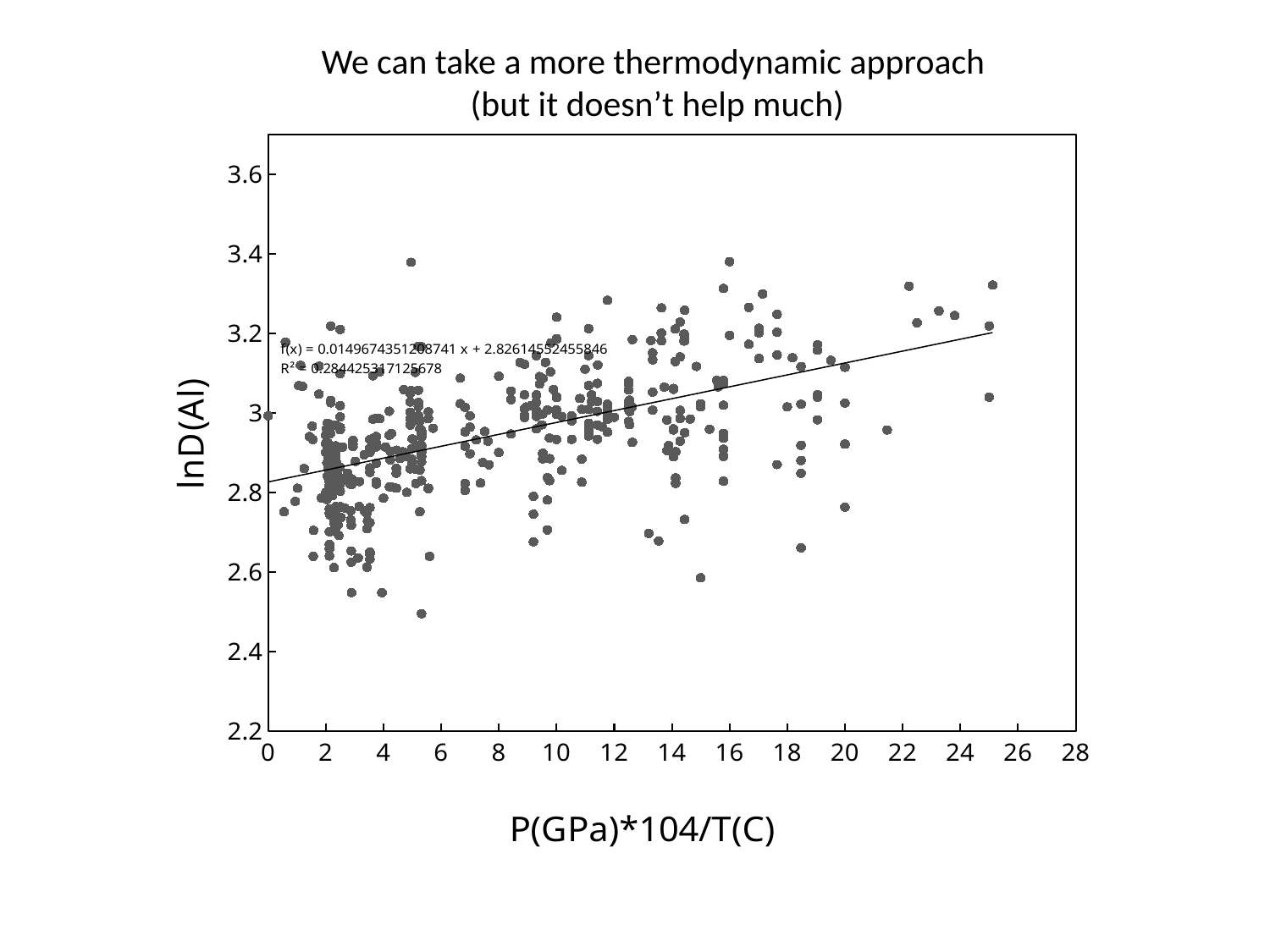
Is the trendline value at x = 0 greater or less than 3.0? less What is the label on the y axis of the chart? lnD(Al) Is the trendline value at x = 25 greater or less than 3.0? greater What is the title of the slide above the chart? We can take a more thermodynamic approach (but it doesn't help much) What kind of chart is shown on the slide? Scatter chart What R² value is printed for the trendline on the chart? 0.284425317125678 Do the plotted lnD(Al) values generally rise or fall as the x-axis value increases? Rise Is the lowest plotted point on the chart greater or less than 2.6? less What is the intercept of the fitted trendline f(x) shown on the chart? 2.82614552455846 What is the maximum value shown on the x axis of the chart? 28 What is the slope of the fitted trendline shown on the chart? 0.0149674351208741